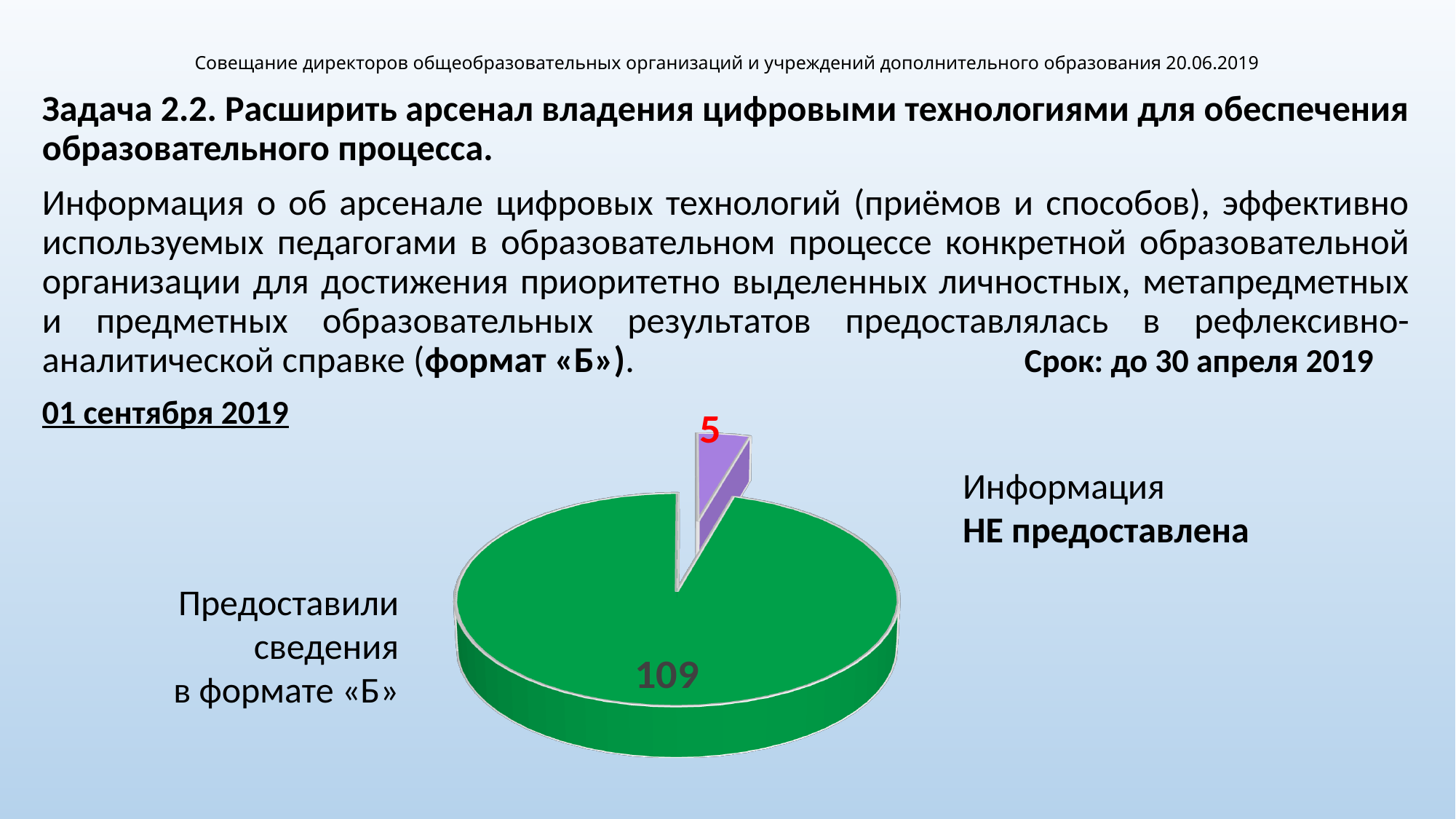
What is the total of the two values shown in the pie chart? 114 What value is shown on the purple slice of the pie chart (Информация НЕ предоставлена)? 5 Which is larger: the number that provided information (Предоставили сведения) or the number that did not (НЕ предоставлена)? Предоставили сведения What value is shown on the green slice of the pie chart (Предоставили сведения в формате «Б»)? 109 What share of the pie does the slice labelled 5 (Информация НЕ предоставлена) represent? 4.4% How many slices does the pie chart have? 2 What is the difference between the number of organisations that provided information in format «Б» and those that did not? 104 What colour is the slice representing organisations that did not provide information? purple What date is shown above the pie chart as the reporting date? 01 сентября 2019 What type of chart is shown on the slide? pie chart Which slice of the pie chart has the smallest value? Информация НЕ предоставлена (5) Which slice of the pie chart has the largest value? Предоставили сведения в формате «Б» (109)